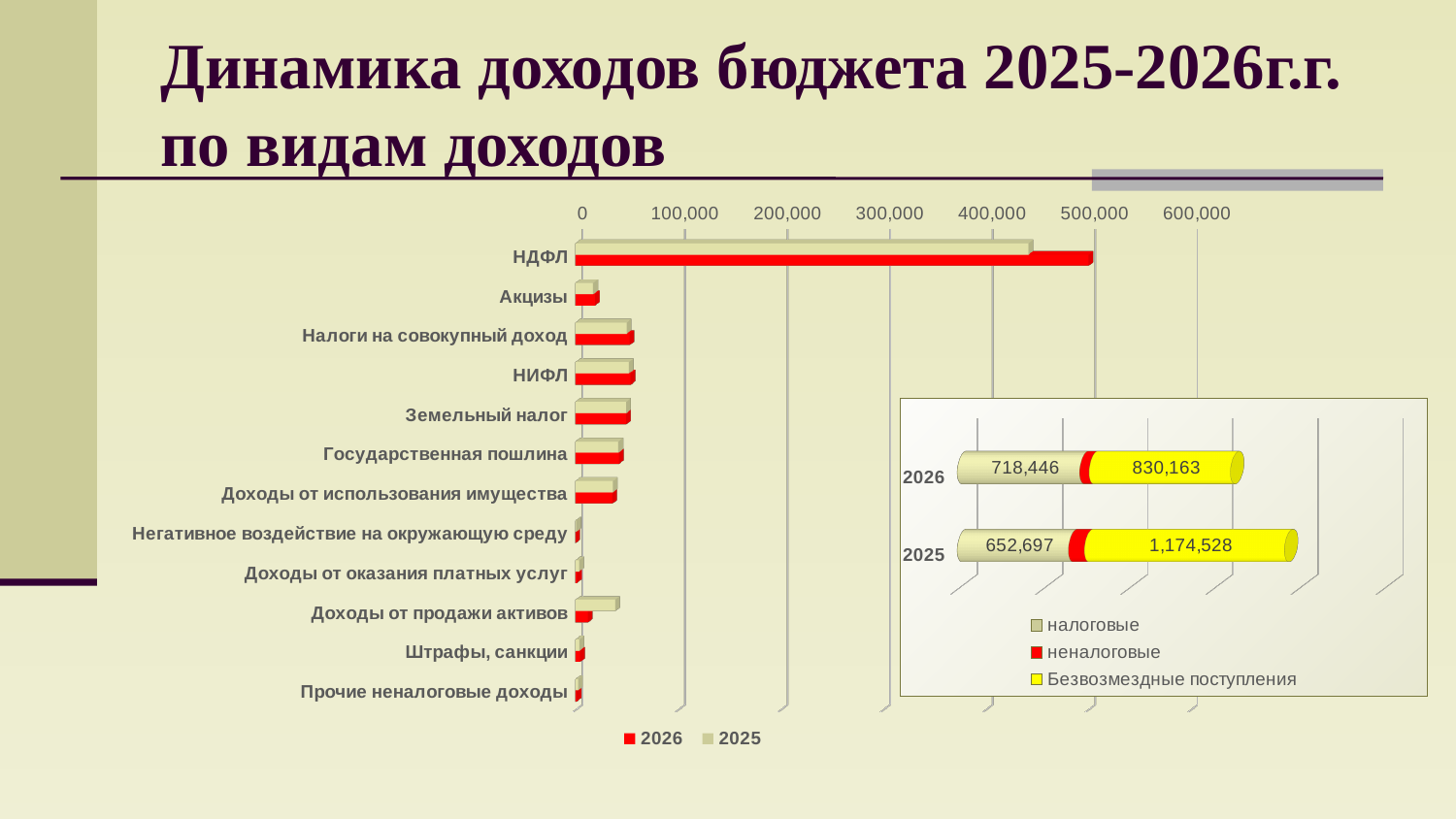
In the inset chart on the right, what is the value of налоговые for 2026? 718,446 In the inset chart on the right, how many series does the legend list? 3 In the inset chart on the right, what is the value of Безвозмездные поступления for 2025? 1,174,528 In the large chart on the left, is the 2025 value for НДФЛ greater or less than 500,000? less In the large chart on the left, how many income categories are listed on the vertical axis? 12 In the large chart on the left, for Доходы от продажи активов, which year has the larger value, 2026 or 2025? 2025 In the large chart on the left, is the 2026 value for НДФЛ greater or less than 400,000? greater In the inset chart on the right, what is the difference between Безвозмездные поступления in 2025 and in 2026? 344,365 In the large chart on the left, which category has the highest value for 2026? НДФЛ In the large chart on the left, for НДФЛ, which year has the larger value, 2026 or 2025? 2026 In the large chart on the left, how many series does the legend list? 2 What kind of chart is the large chart on the left of the slide? bar chart